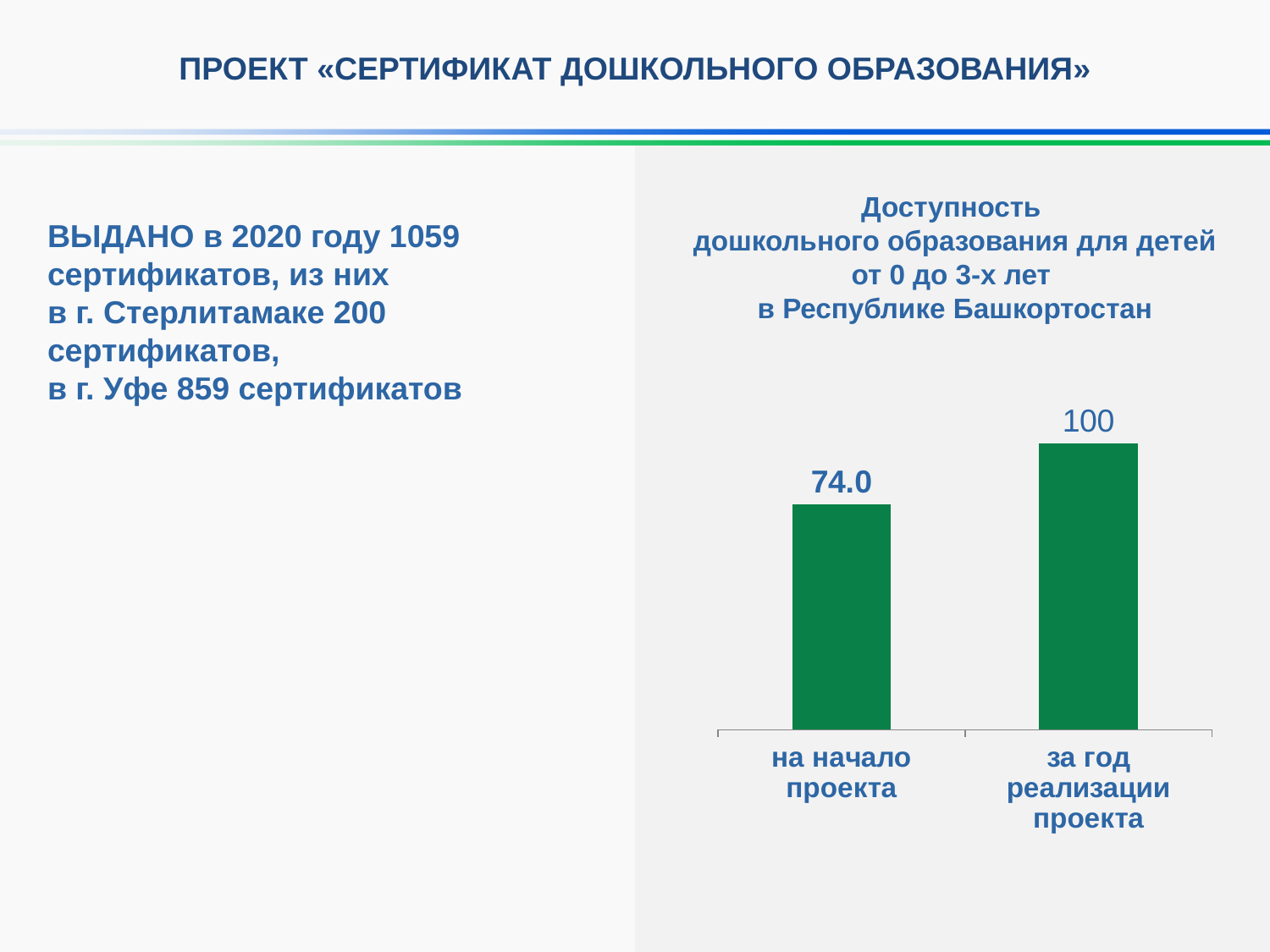
What is the value for "на начало проекта"? 74.0 What is the title of the chart? Доступность дошкольного образования для детей от 0 до 3-х лет в Республике Башкортостан What colour are the bars in the chart? green Which category has the highest value? за год реализации проекта How many categories are shown in the chart? 2 What is the difference between the value for "за год реализации проекта" and the value for "на начало проекта"? 26.0 What is the value for "за год реализации проекта"? 100 Which is larger: the value for "на начало проекта" or the value for "за год реализации проекта"? за год реализации проекта Do the values rise or fall from left to right along the x axis? rise Which category has the lowest value? на начало проекта What kind of chart is shown on the slide? bar chart